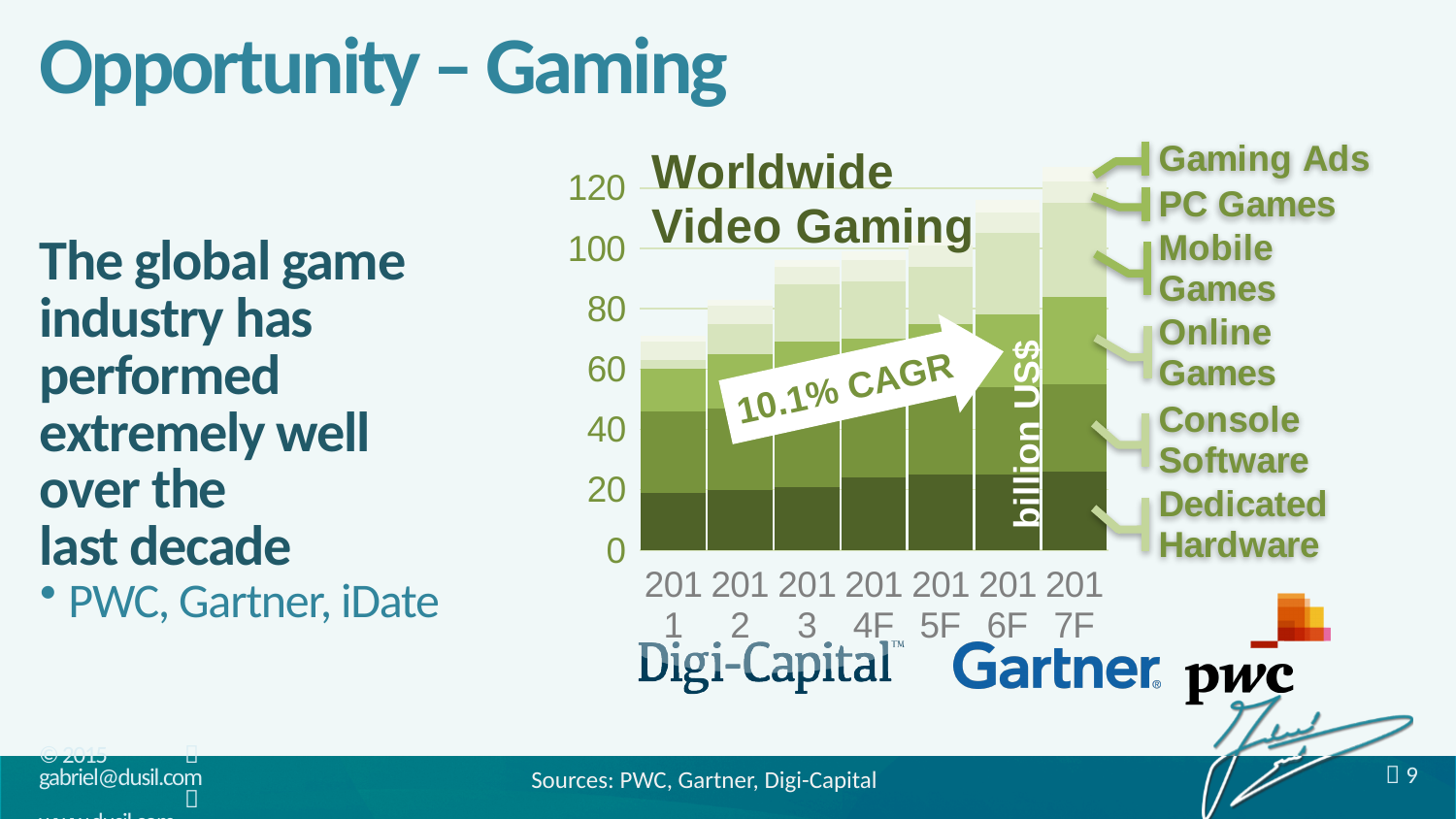
Which is larger, the total for 2013 or the total for 2011? 2013 Do the total values rise or fall from 2011 to 2017F? rise Is the total value for 2011 greater or less than 80? less Which year has the shortest stacked bar in the chart? 2011 What kind of chart is shown on the slide? stacked bar chart What CAGR is annotated on the chart? 10.1% CAGR Is the total value for 2013 greater or less than 80? greater How many years (categories) are plotted along the x axis of the chart? 7 Which year has the tallest stacked bar in the chart? 2017F What is the title of the chart? Worldwide Video Gaming How many series (segments) does the chart's legend list? 6 Is the total value for 2016F greater or less than 100? greater